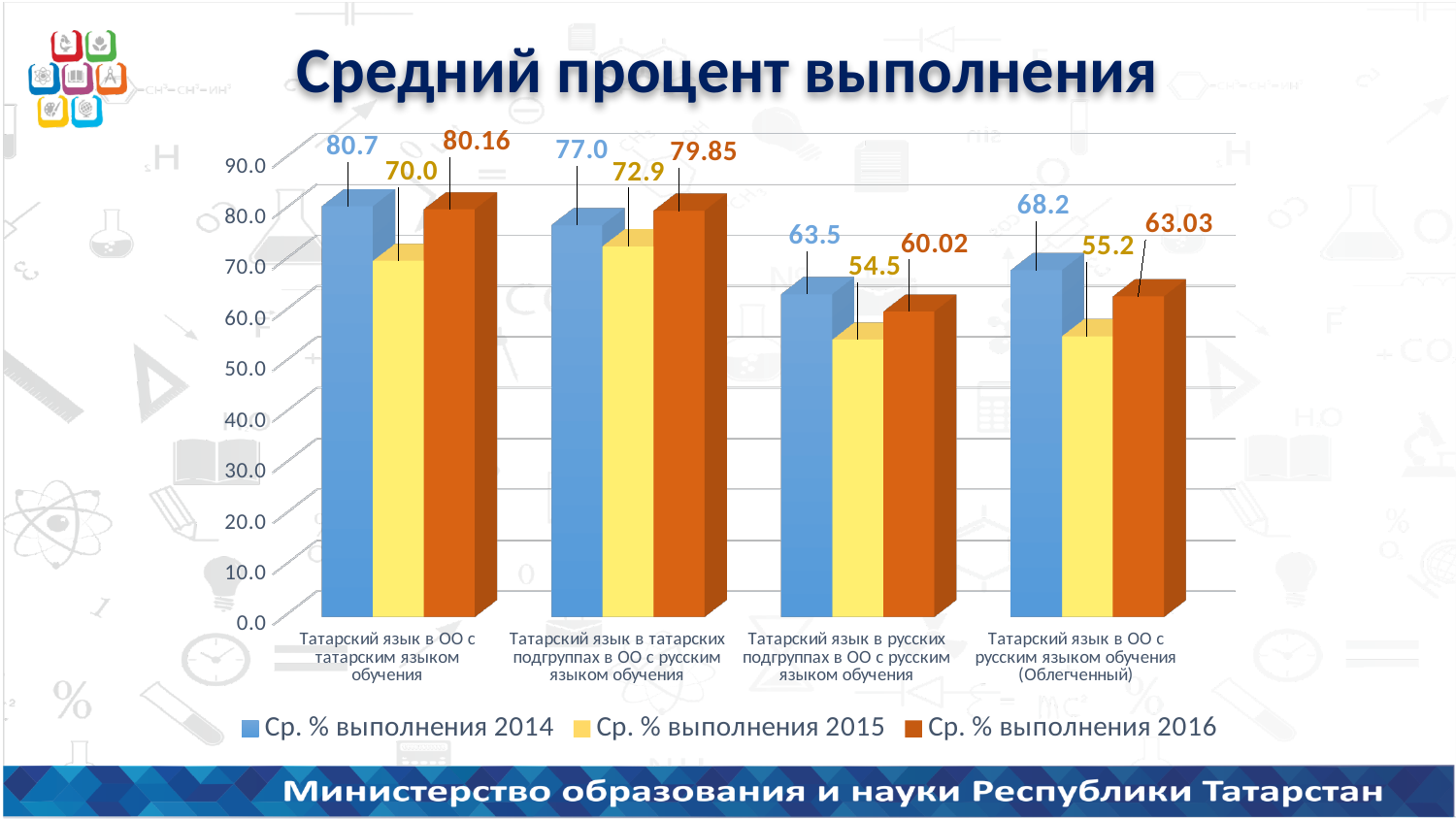
What is the value of Ср. % выполнения 2014 for «Татарский язык в ОО с татарским языком обучения»? 80.7 What is the title of the chart? Средний процент выполнения Which is larger for «Татарский язык в ОО с русским языком обучения (Облегченный)»: Ср. % выполнения 2014 or Ср. % выполнения 2016? Ср. % выполнения 2014 What kind of chart is shown on the slide? Bar chart What is the value of Ср. % выполнения 2016 for «Татарский язык в татарских подгруппах в ОО с русским языком обучения»? 79.85 What is the difference between Ср. % выполнения 2014 and Ср. % выполнения 2015 for «Татарский язык в ОО с татарским языком обучения»? 10.7 How many categories are shown on the x axis? 4 Which category has the highest value for Ср. % выполнения 2015? Татарский язык в татарских подгруппах в ОО с русским языком обучения What is the value of Ср. % выполнения 2015 for «Татарский язык в русских подгруппах в ОО с русским языком обучения»? 54.5 Which category has the lowest value for Ср. % выполнения 2014? Татарский язык в русских подгруппах в ОО с русским языком обучения What is the value of Ср. % выполнения 2016 for «Татарский язык в ОО с русским языком обучения (Облегченный)»? 63.03 How many series does the legend list? 3